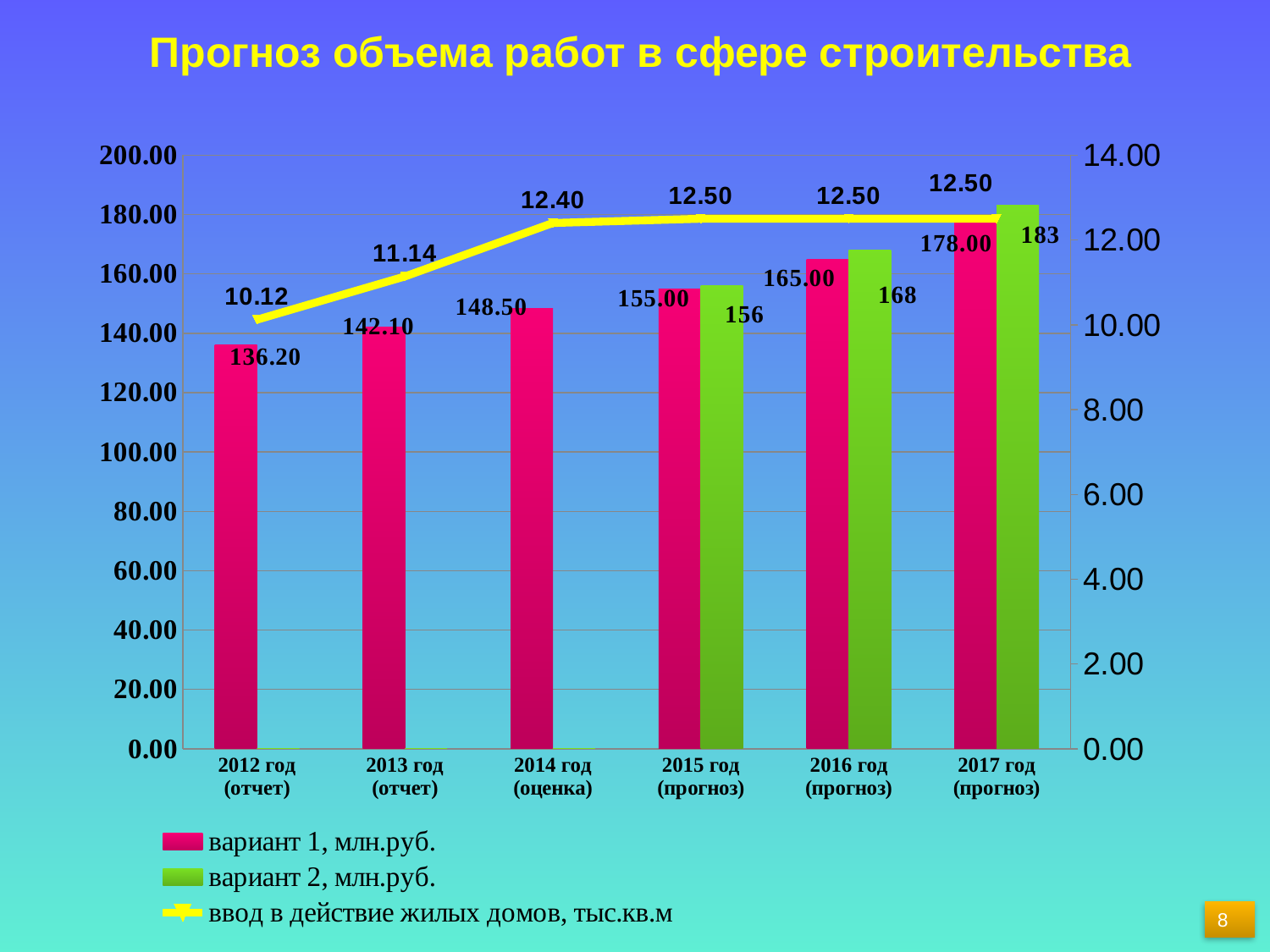
What is the value of "вариант 2, млн.руб." for 2017 год (прогноз)? 183 Which year has the lowest value for "ввод в действие жилых домов, тыс.кв.м"? 2012 год (отчет) What is the value of "вариант 1, млн.руб." for 2016 год (прогноз)? 165.00 Which is larger for 2015 год (прогноз): "вариант 1, млн.руб." or "вариант 2, млн.руб."? вариант 2, млн.руб. Does the value of "вариант 1, млн.руб." rise or fall from 2012 to 2017? rise How many series does the legend list? 3 What is the value of "вариант 1, млн.руб." for 2012 год (отчет)? 136.20 What is the title of the chart? Прогноз объема работ в сфере строительства How many year categories are shown on the x axis? 6 Which year has the highest value for "вариант 1, млн.руб."? 2017 год (прогноз) What is the value of "ввод в действие жилых домов, тыс.кв.м" for 2014 год (оценка)? 12.40 What is the difference between "вариант 2, млн.руб." and "вариант 1, млн.руб." for 2016 год (прогноз)? 3